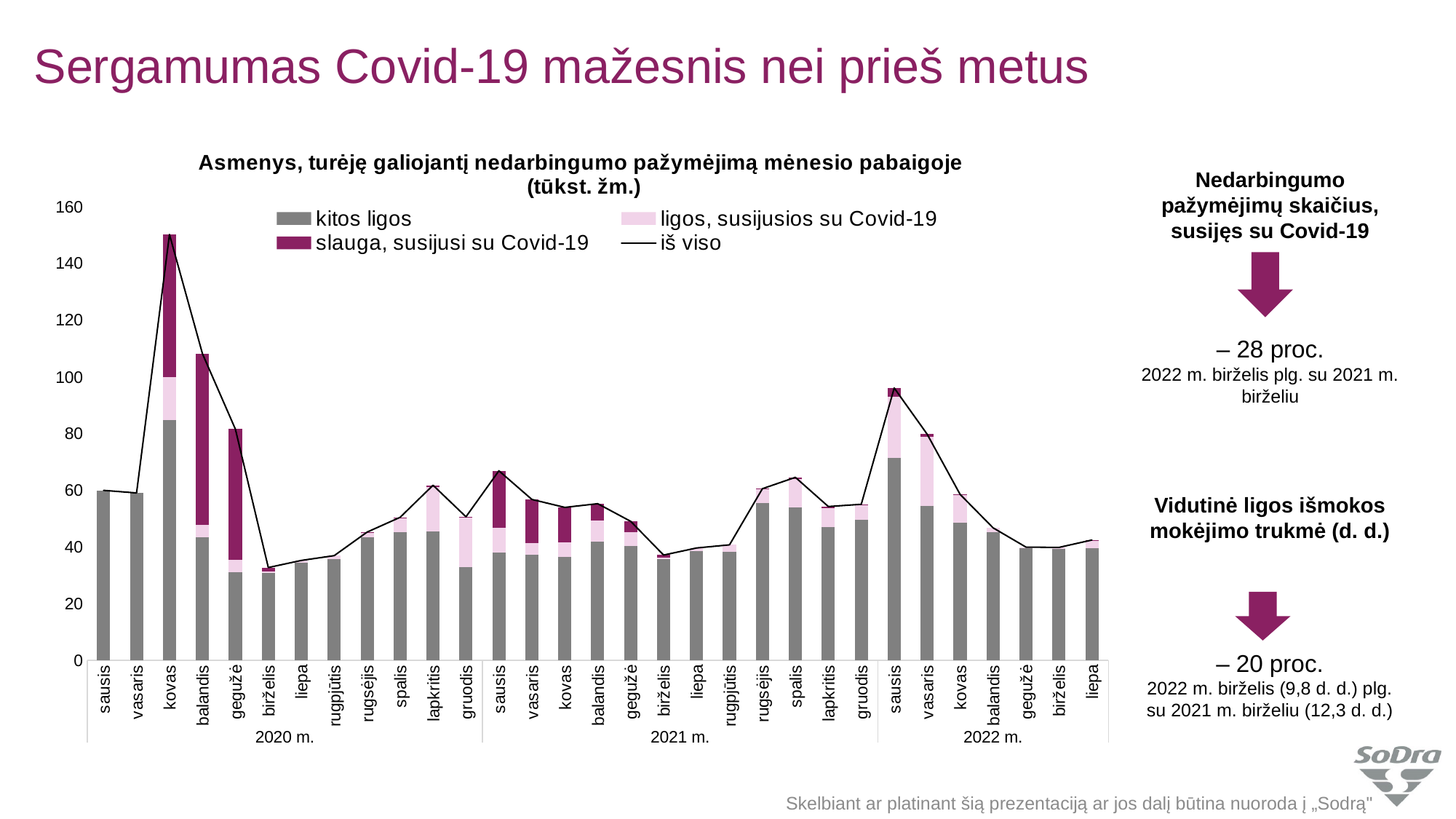
Is the total value for 2020 m. birželis greater or less than 40? less Do the total values rise or fall from 2022 m. sausis to 2022 m. liepa? fall Is the total value for 2022 m. sausis greater or less than 100? less Which month has the highest total value in the chart? 2020 m. kovas What kind of chart is shown on the slide? stacked bar chart with a line Is the total value for 2020 m. kovas greater or less than 140? greater Which has the larger total value, 2020 m. kovas or 2022 m. sausis? 2020 m. kovas Which legend entry is shown in dark purple? slauga, susijusi su Covid-19 How many monthly bars are plotted in the chart? 31 Which has the larger total value, 2020 m. balandis or 2020 m. gegužė? 2020 m. balandis How many series does the chart legend list? 4